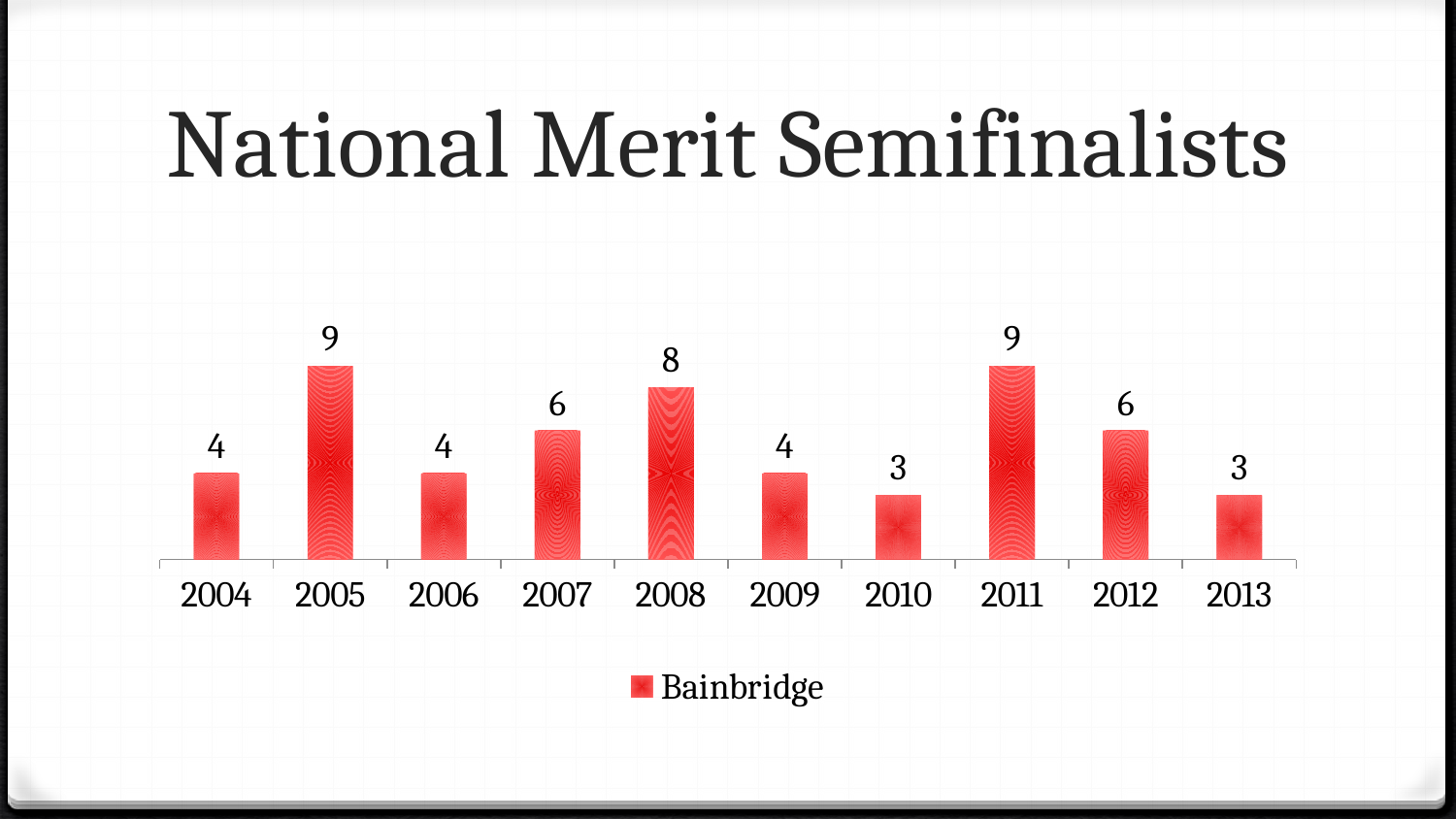
What is the difference between the values for 2005 and 2004? 5 How many National Merit Semifinalists did Bainbridge have in 2008? 8 Which year has the larger value, 2007 or 2008? 2008 Which years have the lowest number of semifinalists? 2010 and 2013 What kind of chart is shown on the slide? Bar chart What is the value for 2010? 3 How many years are shown on the x axis? 10 How many series does the legend list? 1 What is the name of the series in the legend? Bainbridge What is the value for 2012? 6 What is the difference between the values for 2008 and 2009? 4 Which years have the highest number of semifinalists? 2005 and 2011